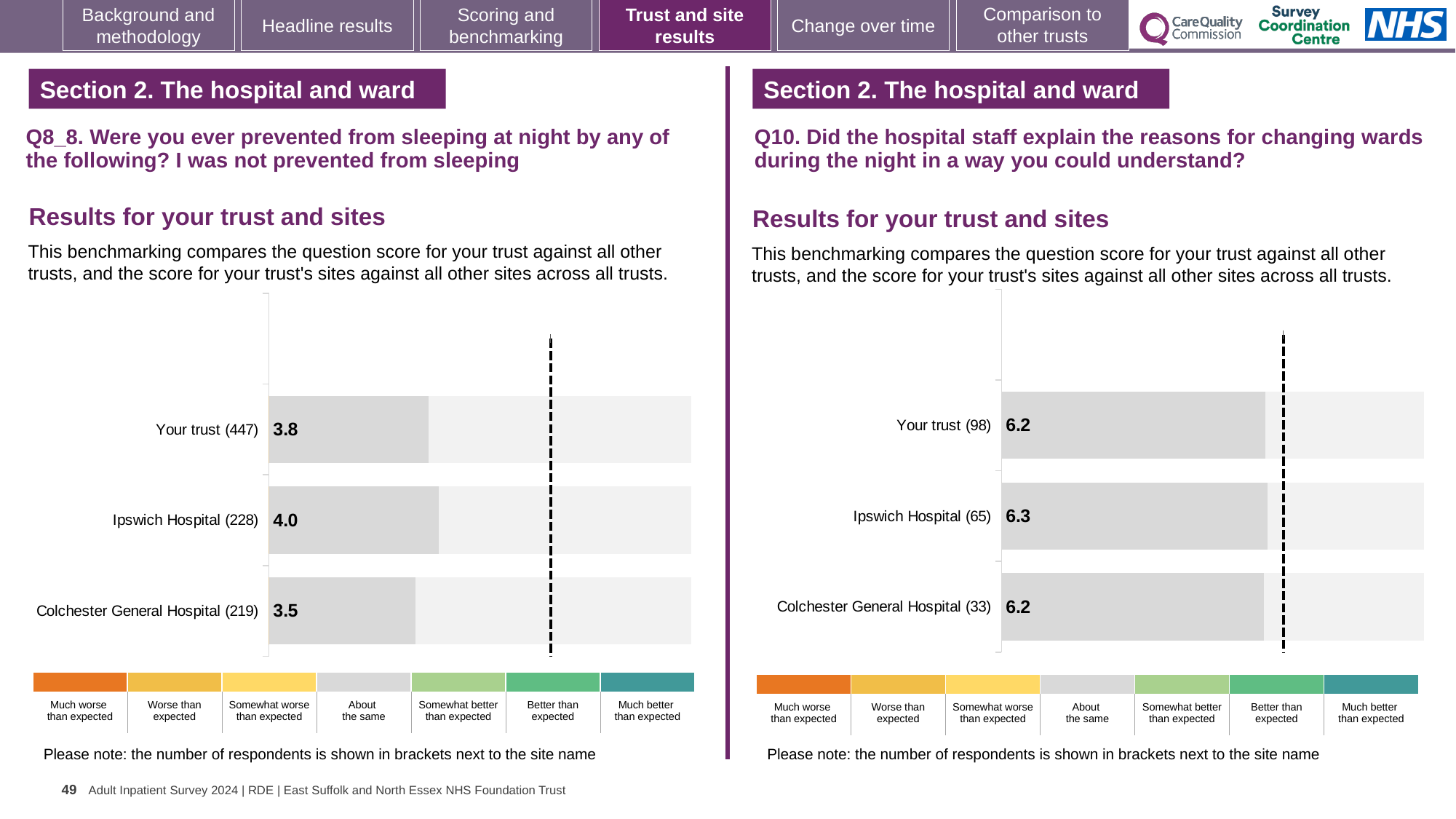
On the right chart (Q10), how many bars are plotted? 3 On the left chart (Q8_8), what is the score for Colchester General Hospital? 3.5 On the left chart (Q8_8), what is the difference between the scores for Ipswich Hospital and Colchester General Hospital? 0.5 On the left chart (Q8_8), what is the score for Your trust? 3.8 On the right chart (Q10), what is the score for Ipswich Hospital? 6.3 On the right chart (Q10), what is the score for Your trust? 6.2 On the left chart (Q8_8), how many respondents are shown in brackets for Your trust? 447 What kind of chart is shown on the left (Q8_8)? Bar chart On the left chart (Q8_8), which site or trust has the lowest score? Colchester General Hospital On the left chart (Q8_8), what is the score for Ipswich Hospital? 4.0 On the left chart (Q8_8), which site or trust has the highest score? Ipswich Hospital On the right chart (Q10), what is the score for Colchester General Hospital? 6.2